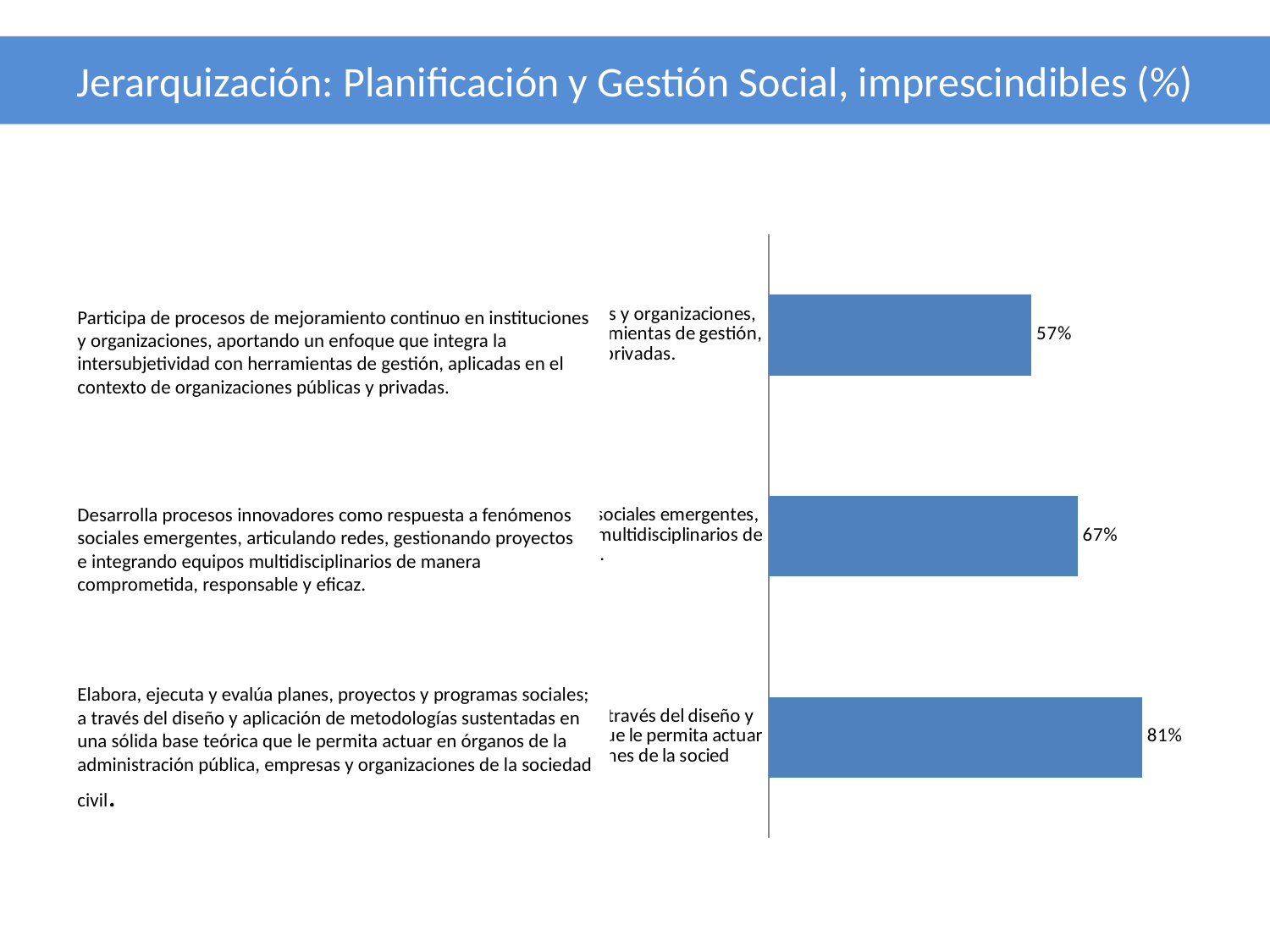
What is the title of the slide? Jerarquización: Planificación y Gestión Social, imprescindibles (%) What is the difference between the highest value (81%) and the lowest value (57%)? 24% Which category has the highest value? Elabora, ejecuta y evalúa planes, proyectos y programas sociales What is the value for the category beginning "Participa de procesos de mejoramiento continuo"? 57% What colour are the bars in the chart? Blue What is the difference between the values for "Desarrolla procesos innovadores" and "Participa de procesos de mejoramiento continuo"? 10% What is the value for the category beginning "Desarrolla procesos innovadores"? 67% What is the value for the category beginning "Elabora, ejecuta y evalúa planes, proyectos y programas sociales"? 81% What kind of chart is shown on the slide? Bar chart Which category has the lowest value? Participa de procesos de mejoramiento continuo en instituciones y organizaciones Which is larger: the value for "Desarrolla procesos innovadores" or the value for "Elabora, ejecuta y evalúa planes"? Elabora, ejecuta y evalúa planes How many categories (bars) are shown in the chart? 3